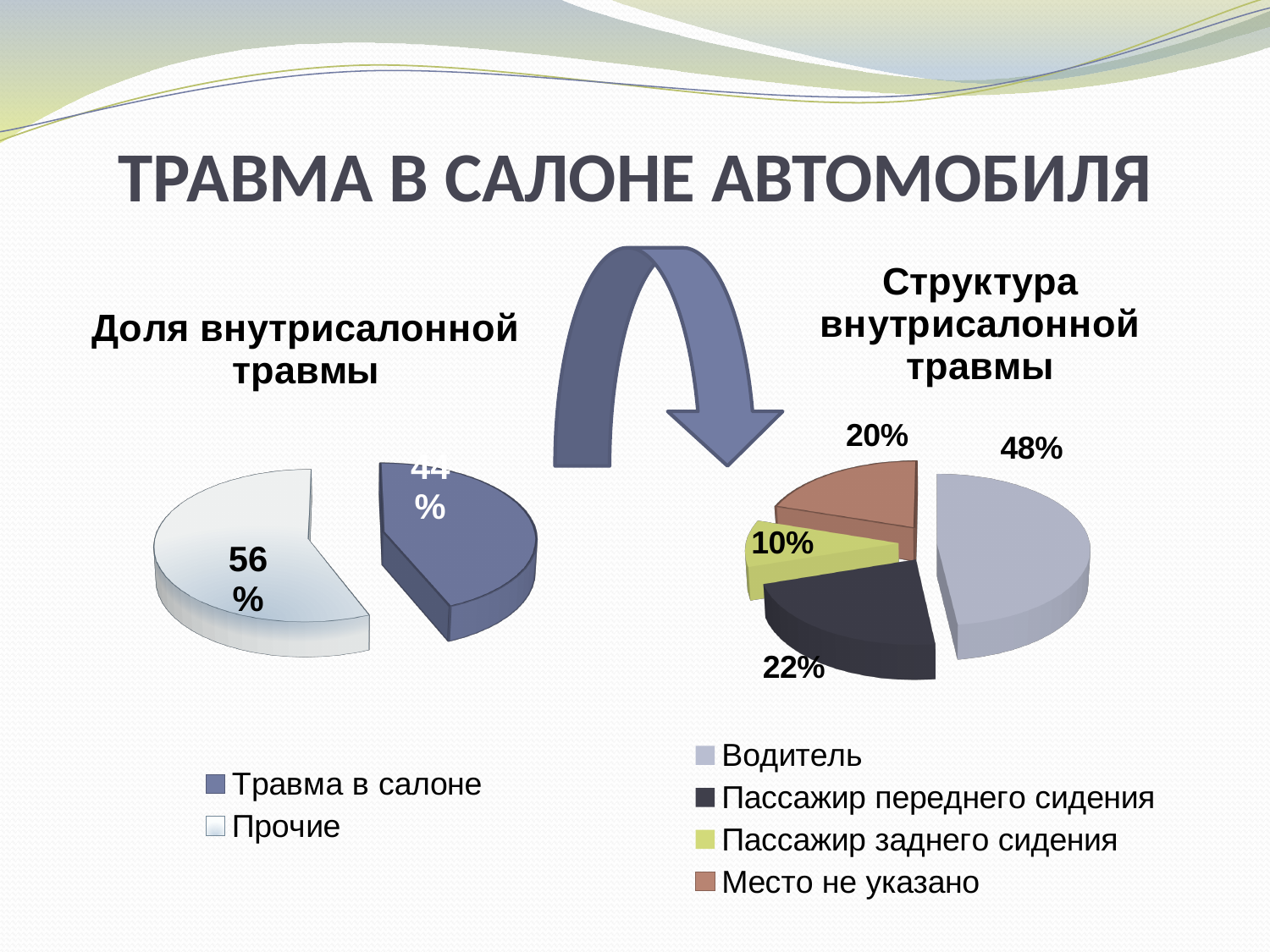
In the chart titled "Доля внутрисалонной травмы", what share is labelled for "Травма в салоне"? 44% In the chart titled "Структура внутрисалонной травмы", how many categories are shown? 4 In the chart titled "Структура внутрисалонной травмы", what share is labelled for "Пассажир заднего сидения"? 10% In the chart titled "Доля внутрисалонной травмы", how many entries does the legend list? 2 In the chart titled "Доля внутрисалонной травмы", what kind of chart is shown? Pie chart In the chart titled "Доля внутрисалонной травмы", what share is labelled for "Прочие"? 56% In the chart titled "Структура внутрисалонной травмы", what share is labelled for "Водитель"? 48% In the chart titled "Структура внутрисалонной травмы", which category has the smallest slice? Пассажир заднего сидения In the chart titled "Доля внутрисалонной травмы", which category has the larger slice? Прочие In the chart titled "Структура внутрисалонной травмы", what share is labelled for "Пассажир переднего сидения"? 22% In the chart titled "Структура внутрисалонной травмы", what share is labelled for "Место не указано"? 20% In the chart titled "Структура внутрисалонной травмы", what is the difference between the shares for "Водитель" and "Пассажир переднего сидения"? 26%